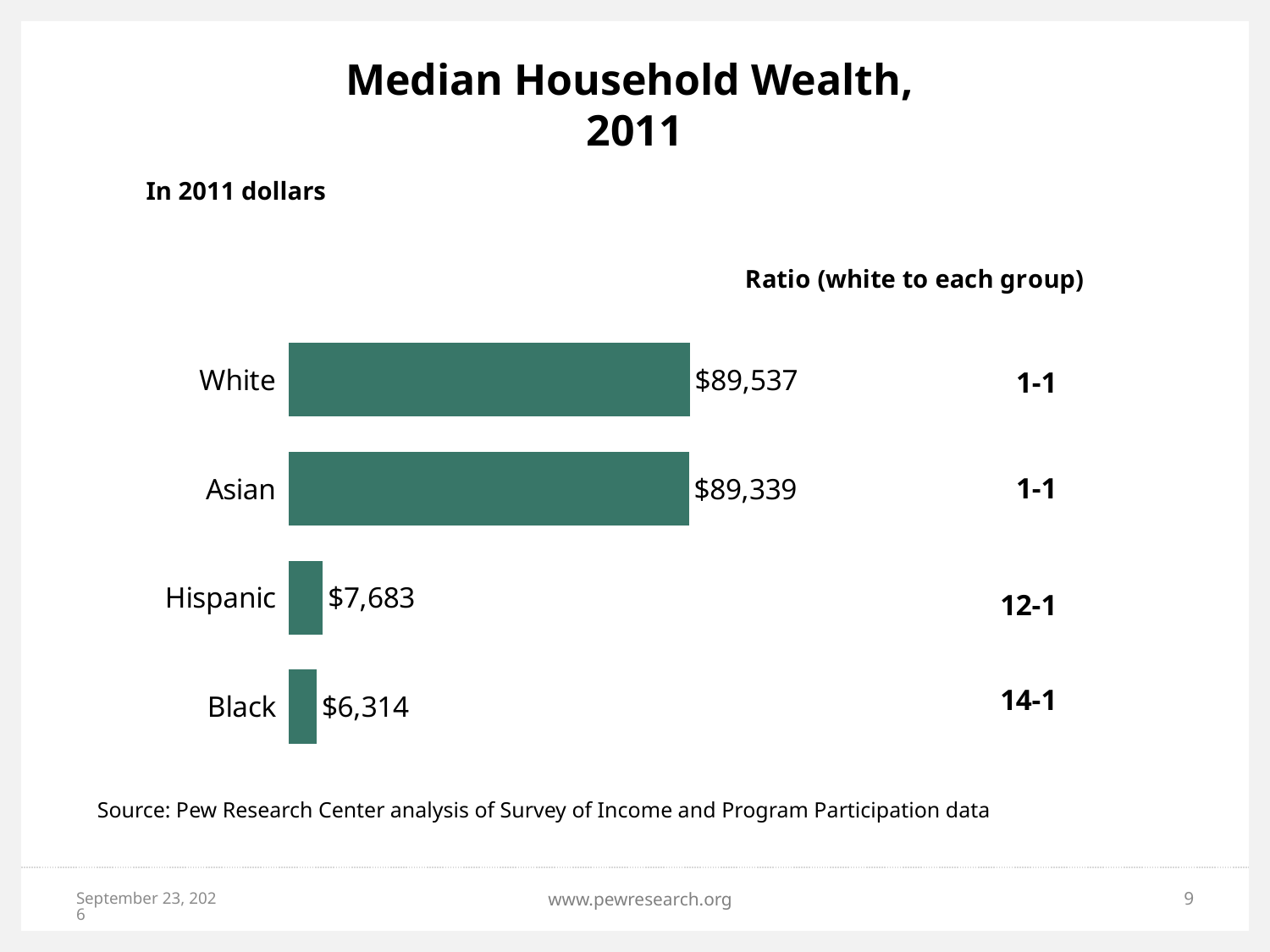
What is the ratio of white to Black median household wealth shown on the slide? 14-1 How many groups are shown in the chart? 4 Which group has a larger median household wealth, Hispanic or Black? Hispanic Which group has the lowest median household wealth? Black What is the median household wealth for White households? $89,537 What is the median household wealth for Hispanic households? $7,683 What is the difference in median household wealth between White and Black households? $83,223 Which group has the highest median household wealth? White What kind of chart is shown on the slide? Bar chart What is the difference in median household wealth between Hispanic and Black households? $1,369 What is the median household wealth for Black households? $6,314 What is the median household wealth for Asian households? $89,339